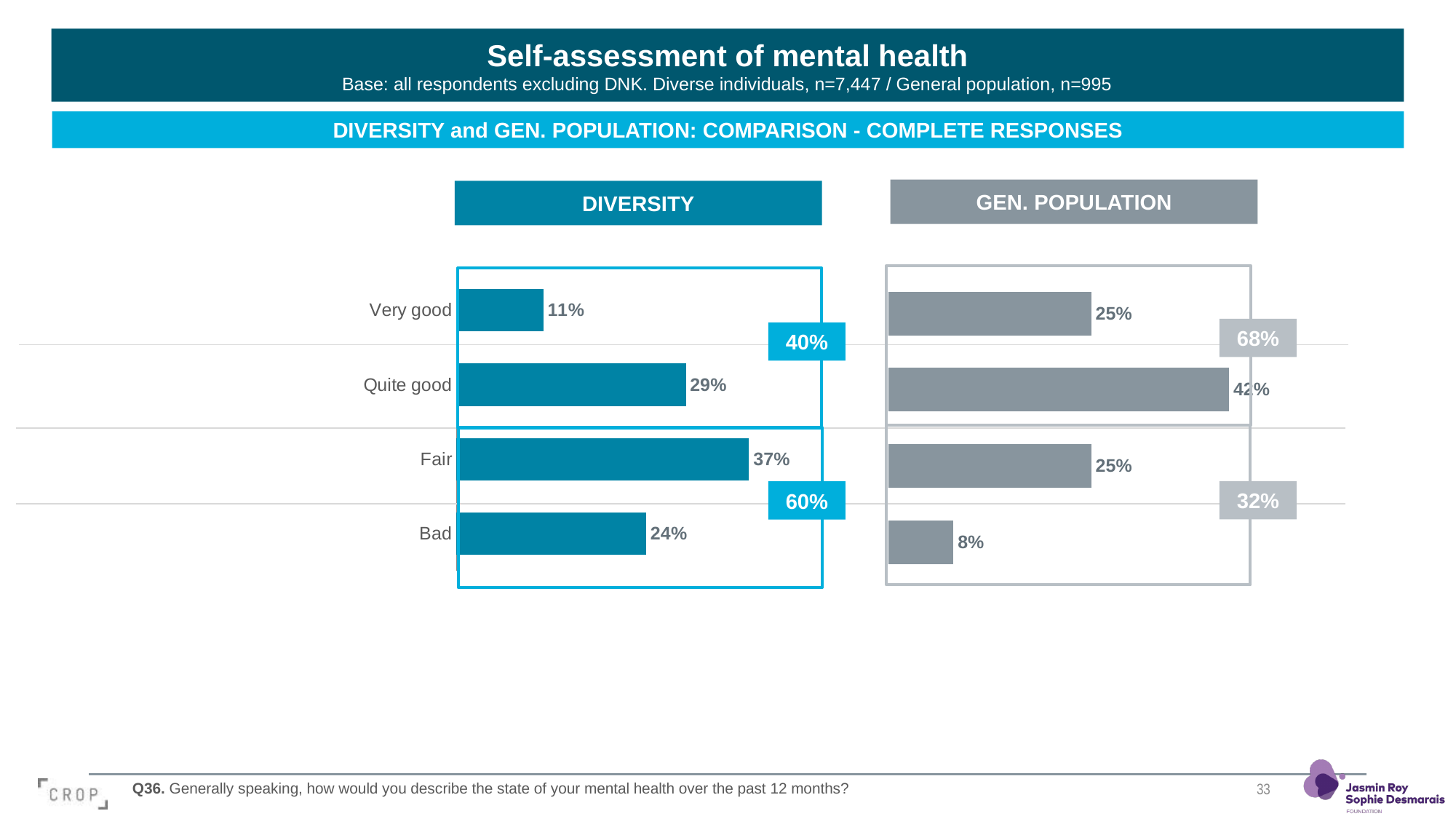
What is the difference between the Quite good values in the GEN. POPULATION chart and the DIVERSITY chart? 13% In the DIVERSITY chart, which category has the lowest value? Very good In the DIVERSITY chart, which category has the highest value? Fair What type of chart is used for the DIVERSITY data? Bar chart In the DIVERSITY chart, what is the value for Very good? 11% What combined percentage is shown for Very good and Quite good in the GEN. POPULATION chart? 68% In the GEN. POPULATION chart, which category has the lowest value? Bad How many categories are shown in the DIVERSITY chart? 4 In the GEN. POPULATION chart, what is the value for Quite good? 42% In the GEN. POPULATION chart, what is the value for Bad? 8% In the DIVERSITY chart, what is the value for Fair? 37% Which is larger: the Bad value in the DIVERSITY chart or the Bad value in the GEN. POPULATION chart? DIVERSITY